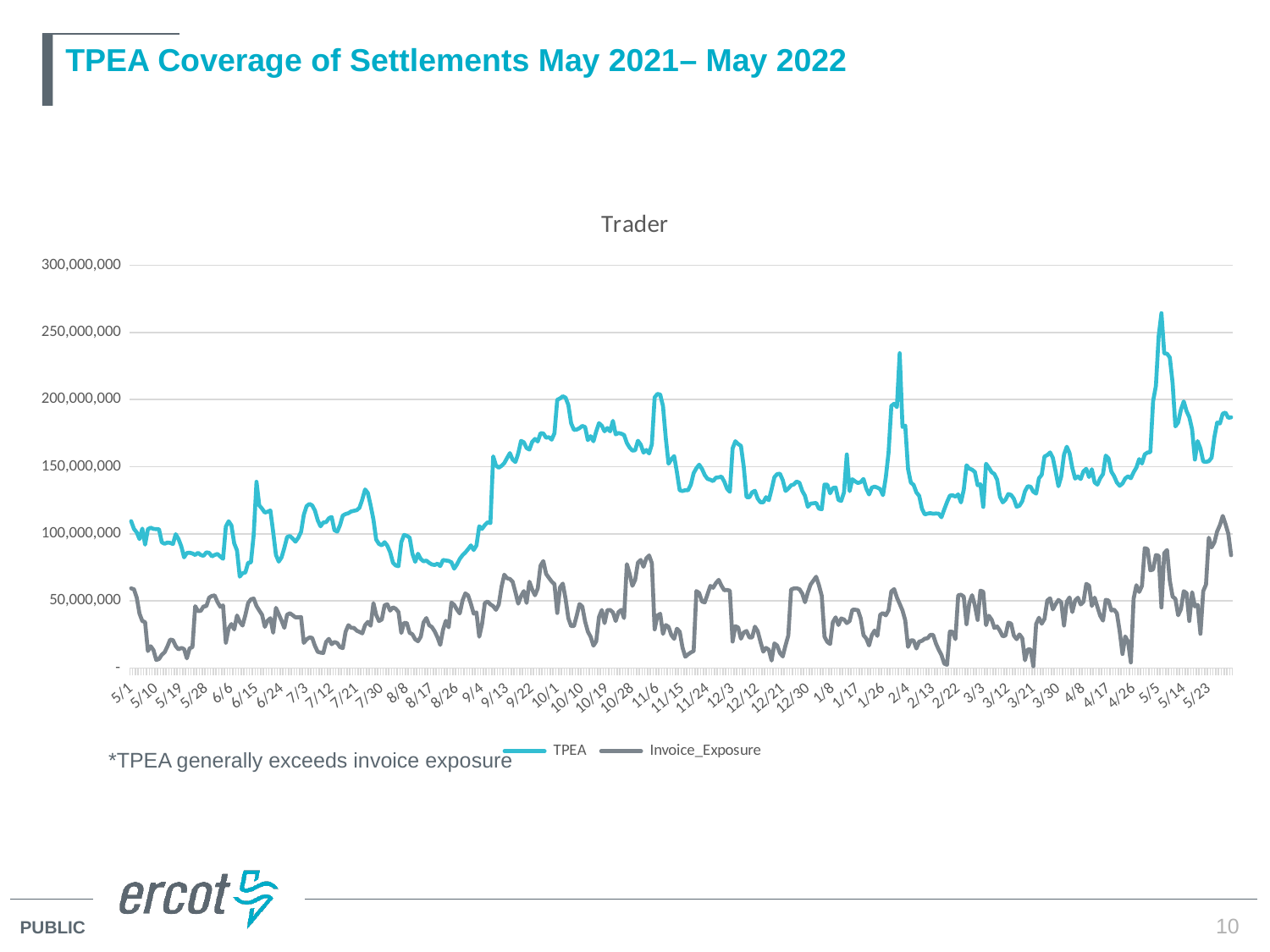
How many series does the chart's legend list? 2 Does the Invoice_Exposure series ever exceed 150,000,000? No At 5/5, which series has the larger value, TPEA or Invoice_Exposure? TPEA What is the highest value labelled on the vertical axis? 300,000,000 Which series reaches the highest value anywhere on the chart, TPEA or Invoice_Exposure? TPEA What kind of chart is shown on the slide? line chart What is the title printed above the chart? Trader Is the peak value of the TPEA series near 5/5 greater or less than 250,000,000? greater Is the Invoice_Exposure value near 11/6 greater or less than 100,000,000? less Which series is drawn in gray in the chart? Invoice_Exposure